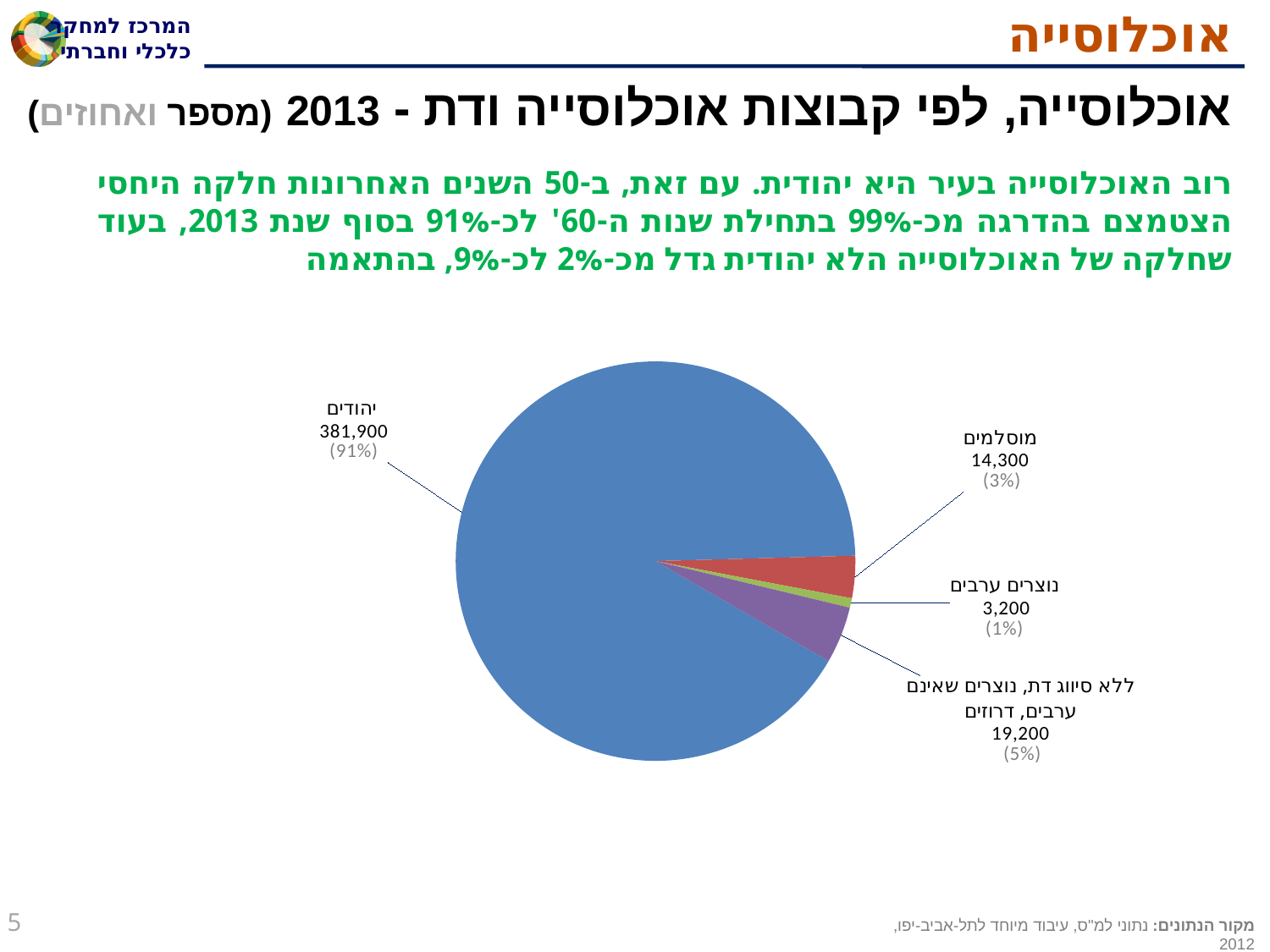
What is the value shown for ללא סיווג דת, נוצרים שאינם ערבים, דרוזים in the pie chart? 19,200 What share of the pie does the יהודים (Jews) slice represent? 91% Which is larger: the value for מוסלמים or the value for ללא סיווג דת, נוצרים שאינם ערבים, דרוזים? ללא סיווג דת, נוצרים שאינם ערבים, דרוזים How many slices does the pie chart have? 4 What is the value shown for יהודים (Jews) in the pie chart? 381,900 What is the value shown for מוסלמים (Muslims) in the pie chart? 14,300 Which category has the largest slice in the pie chart? יהודים What is the difference between the values for מוסלמים and נוצרים ערבים? 11,100 What is the value shown for נוצרים ערבים (Arab Christians) in the pie chart? 3,200 What type of chart is shown on the slide? Pie chart Which category has the smallest slice in the pie chart? נוצרים ערבים What share of the pie does the מוסלמים (Muslims) slice represent? 3%